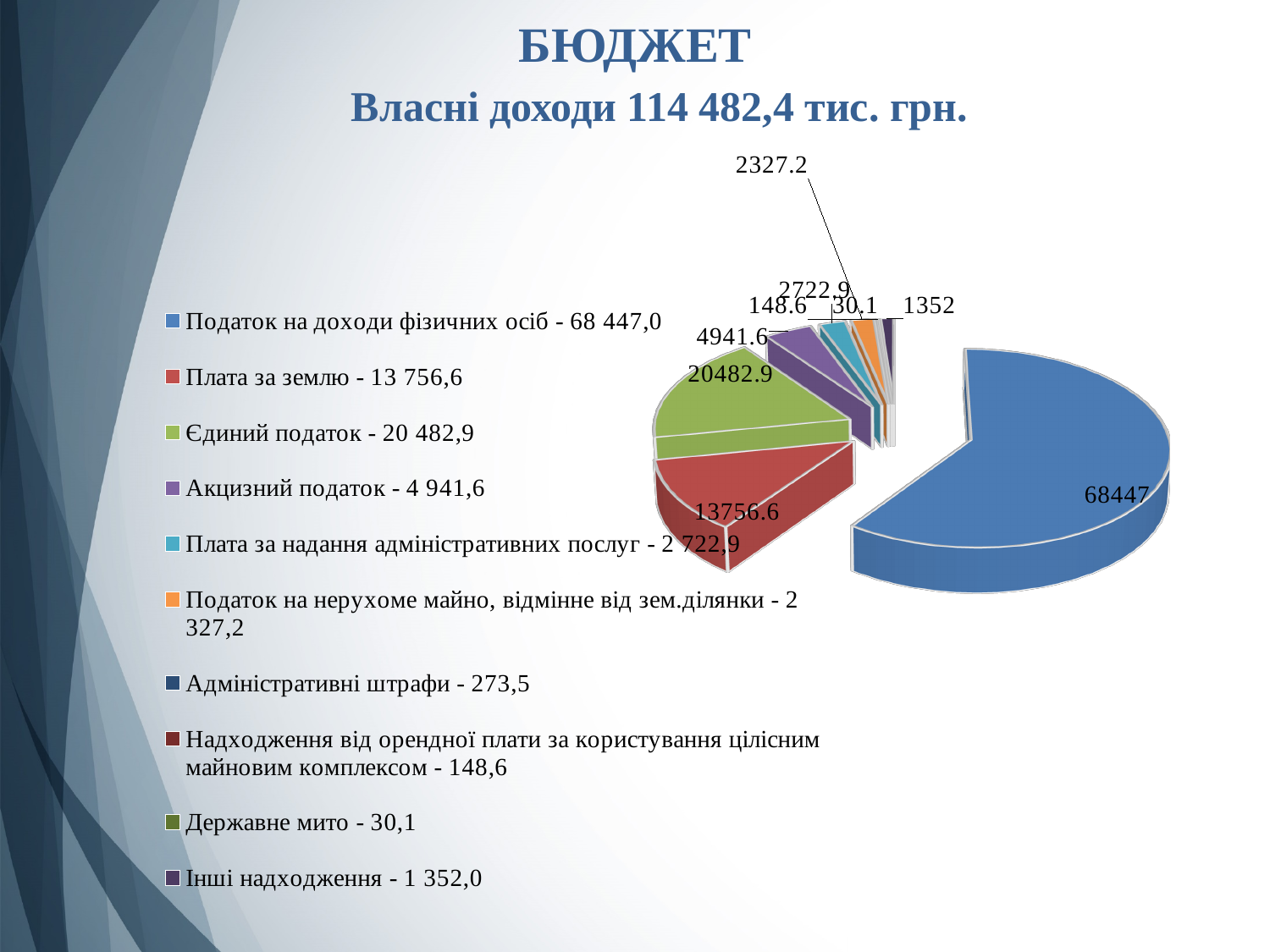
What value is labelled on the pie slice for Плата за землю? 13756.6 What is the difference between the labelled values for Єдиний податок and Плата за землю? 6726.3 Which category has the largest slice of the pie? Податок на доходи фізичних осіб What total of own revenues (Власні доходи) is stated in the slide title? 114 482,4 тис. грн. What value is labelled on the pie slice for Інші надходження? 1352 How many categories does the legend list? 10 What value is labelled on the pie slice for Акцизний податок? 4941.6 What value is labelled on the pie slice for Податок на доходи фізичних осіб? 68447 What kind of chart is shown on the slide? pie chart What value is labelled on the pie slice for Єдиний податок? 20482.9 Which category has the smallest value in the legend? Державне мито Which is larger: the value for Плата за землю or the value for Єдиний податок? Єдиний податок